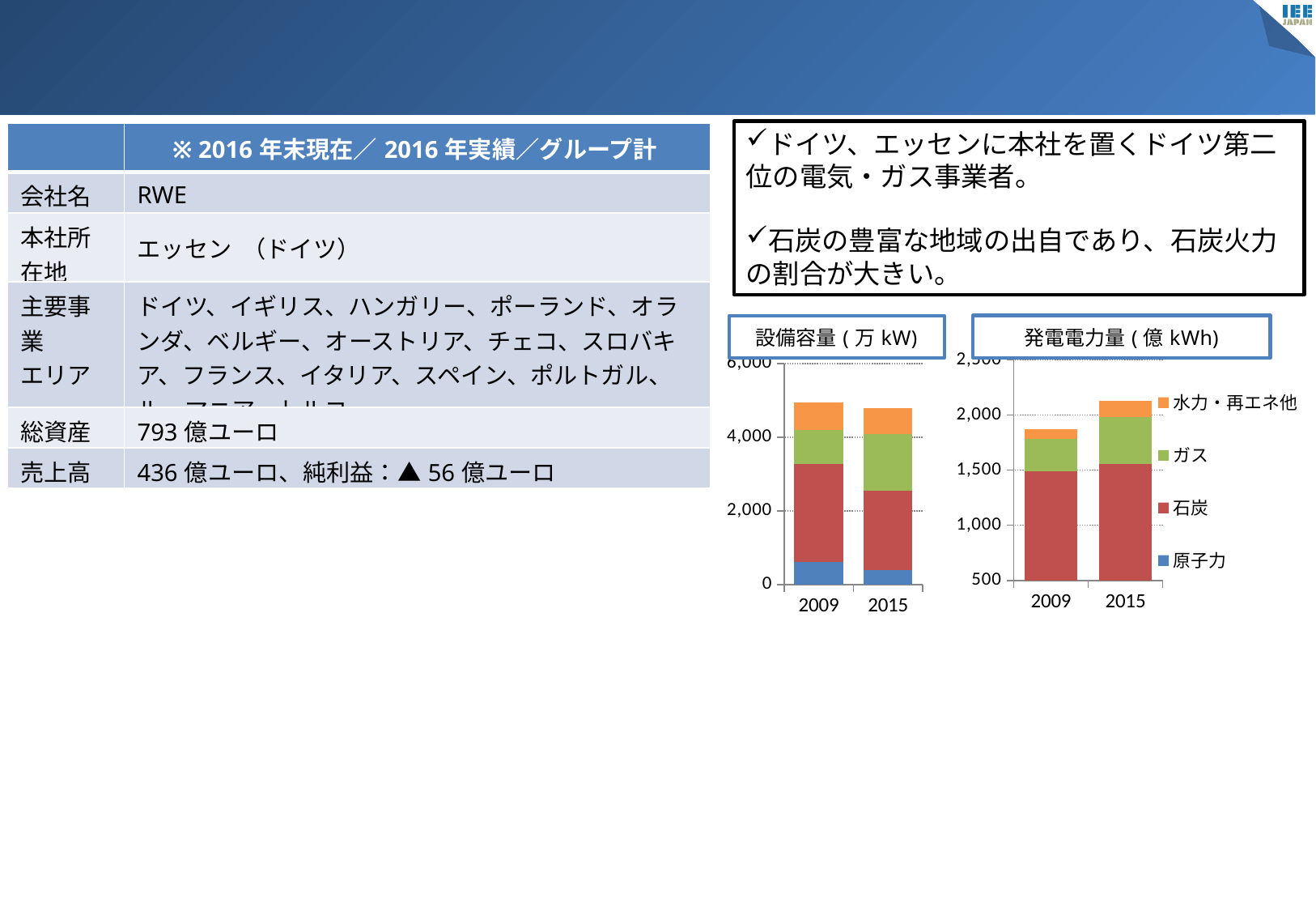
In the 発電電力量 (億 kWh) chart, does the total rise or fall from 2009 to 2015? rise In the 発電電力量 (億 kWh) chart, is the total for 2009 greater or less than 2,000? less What kind of chart is the 設備容量 (万 kW) chart? bar chart In the 発電電力量 (億 kWh) chart, which year has the higher total, 2009 or 2015? 2015 In the 設備容量 (万 kW) chart, is the total for 2015 greater or less than 4,000? greater What is the title of the left chart? 設備容量 (万 kW) How many series does the legend of the 発電電力量 (億 kWh) chart list? 4 Which legend entry is shown in red in the 発電電力量 (億 kWh) chart? 石炭 In the 設備容量 (万 kW) chart, is the total for 2009 greater or less than 4,000? greater How many years are shown on the x axis of the 発電電力量 (億 kWh) chart? 2